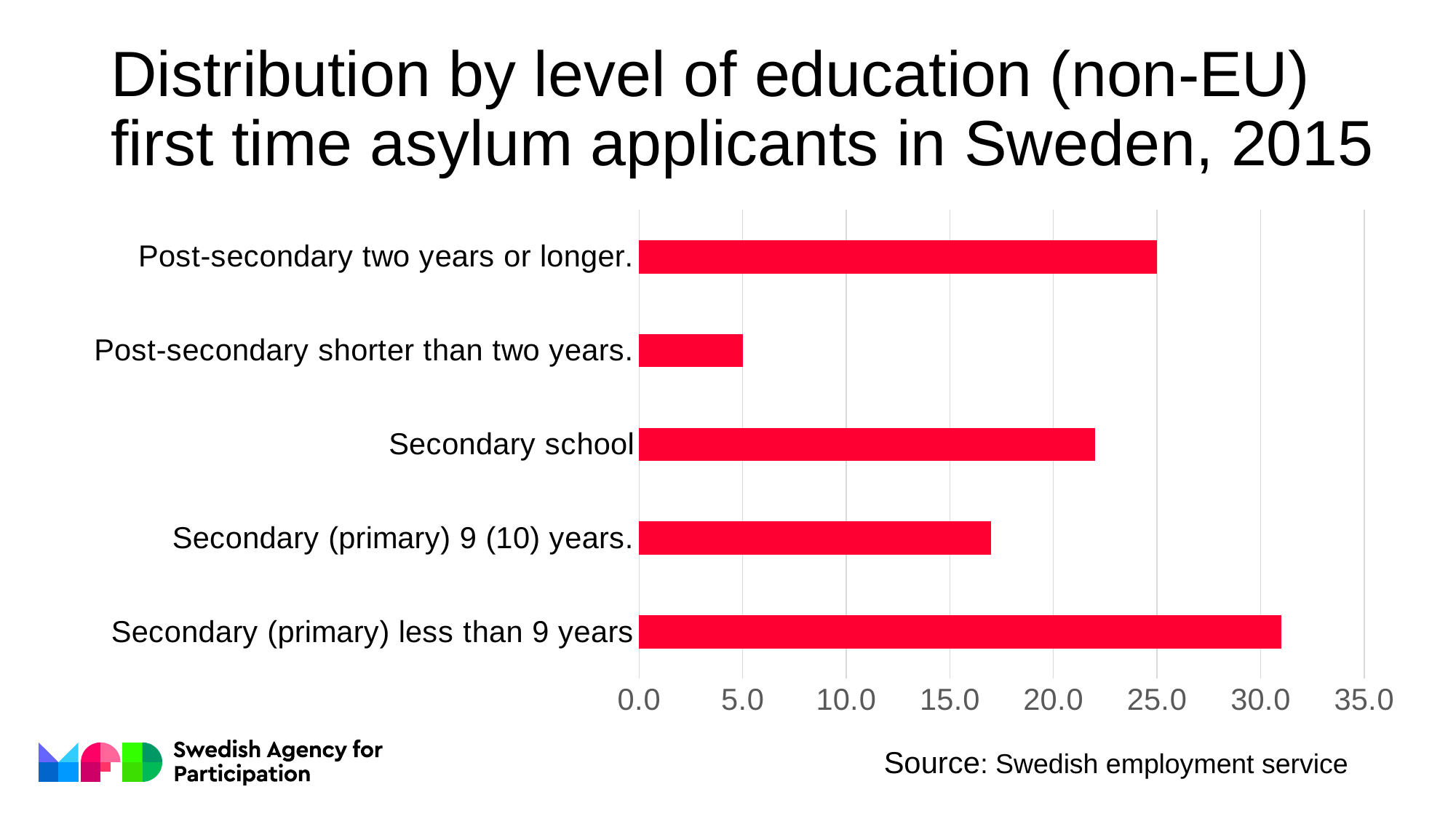
What is the value for Post-secondary two years or longer? 25.0 What is the title of the chart? Distribution by level of education (non-EU) first time asylum applicants in Sweden, 2015 What kind of chart is shown on the slide? Bar chart Which education category has the lowest value? Post-secondary shorter than two years. What colour are the bars in the chart? Red Is the value for Secondary (primary) less than 9 years greater or less than 30.0? greater Which education category has the highest value? Secondary (primary) less than 9 years Which is larger, the value for Secondary school or the value for Secondary (primary) 9 (10) years? Secondary school Is the value for Secondary school greater or less than 20.0? greater What is the value for Post-secondary shorter than two years? 5.0 How many education categories are plotted in the chart? 5 Is the value for Secondary (primary) 9 (10) years greater or less than 20.0? less